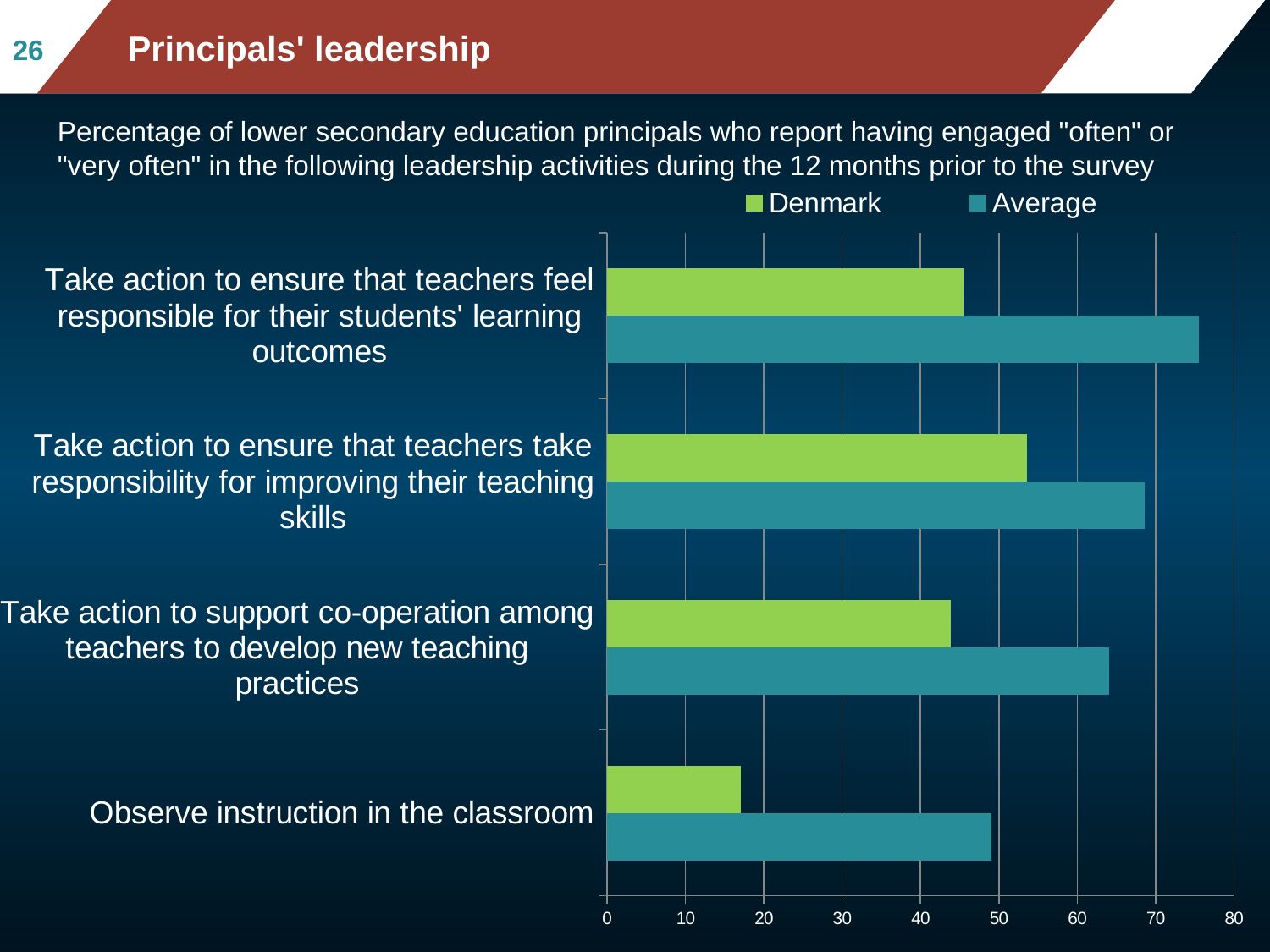
For 'Observe instruction in the classroom', which is larger: the Denmark value or the Average value? Average Is the Denmark value for 'Take action to ensure that teachers take responsibility for improving their teaching skills' greater or less than 50? greater Which colour represents Denmark in the legend? Green How many series does the legend list? 2 Is the Denmark value for 'Observe instruction in the classroom' greater or less than 20? less How many leadership activities (categories) are plotted on the chart? 4 Is the Average value for 'Take action to ensure that teachers feel responsible for their students' learning outcomes' greater or less than 70? greater For which leadership activity is the Denmark value highest? Take action to ensure that teachers take responsibility for improving their teaching skills For which leadership activity is the Average value highest? Take action to ensure that teachers feel responsible for their students' learning outcomes For which leadership activity is the Average value lowest? Observe instruction in the classroom What kind of chart is shown on the slide? Bar chart For which leadership activity is the Denmark value lowest? Observe instruction in the classroom